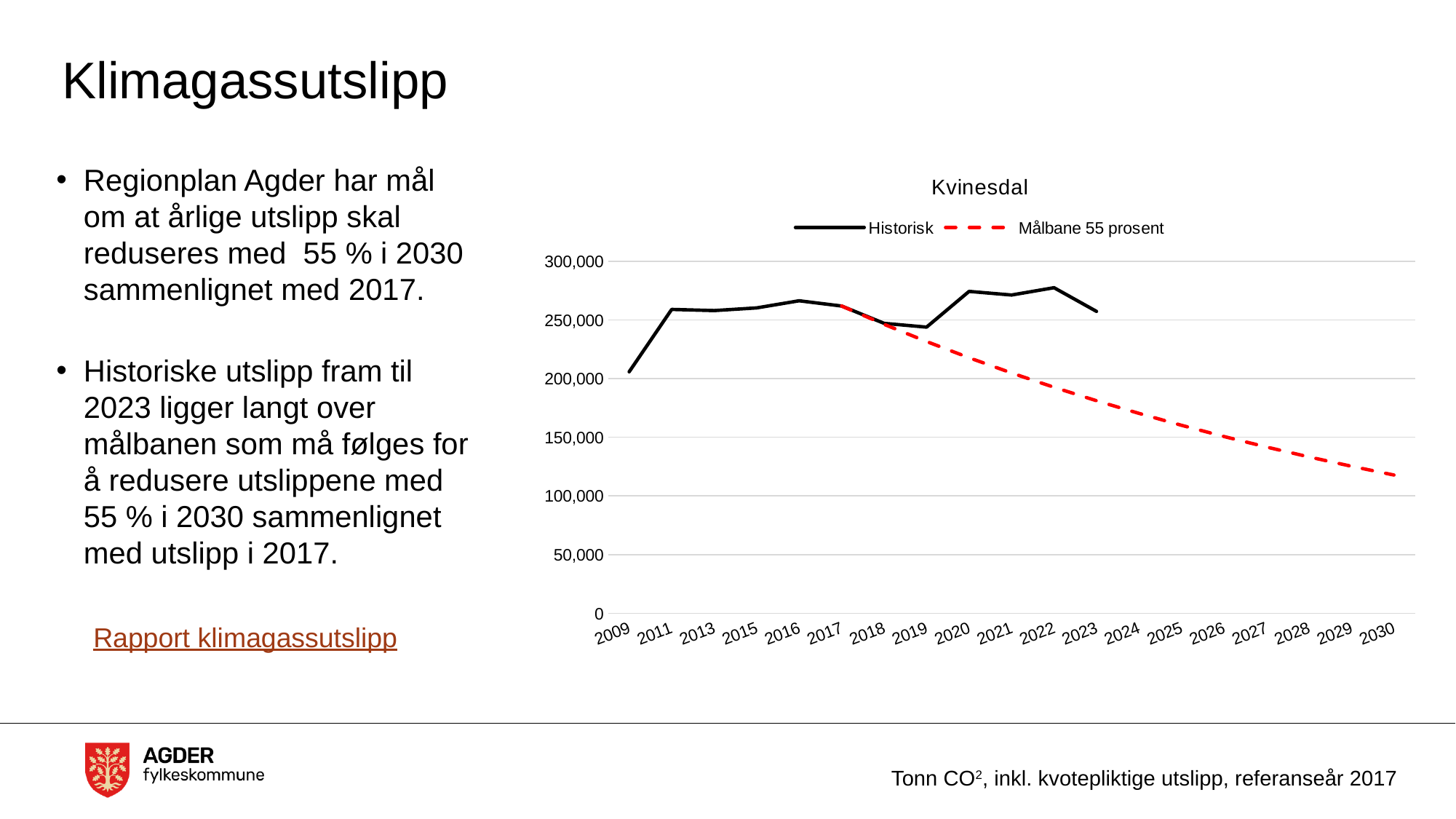
Is the Målbane 55 prosent value for 2030 greater or less than 150,000? less How many series does the chart legend list? 2 What is the title of the chart? Kvinesdal In which year does the Målbane 55 prosent series reach its lowest value? 2030 What kind of chart is shown on the slide? Line chart What are the two series named in the chart legend? Historisk and Målbane 55 prosent Is the Historisk value for 2009 greater or less than 250,000? less Does the Målbane 55 prosent series rise or fall from 2017 to 2030? Fall How many years are labelled on the x axis of the chart? 19 Is the Historisk value for 2022 greater or less than 250,000? greater In which year is the Historisk series at its lowest value? 2009 In 2023, which series has the higher value, Historisk or Målbane 55 prosent? Historisk